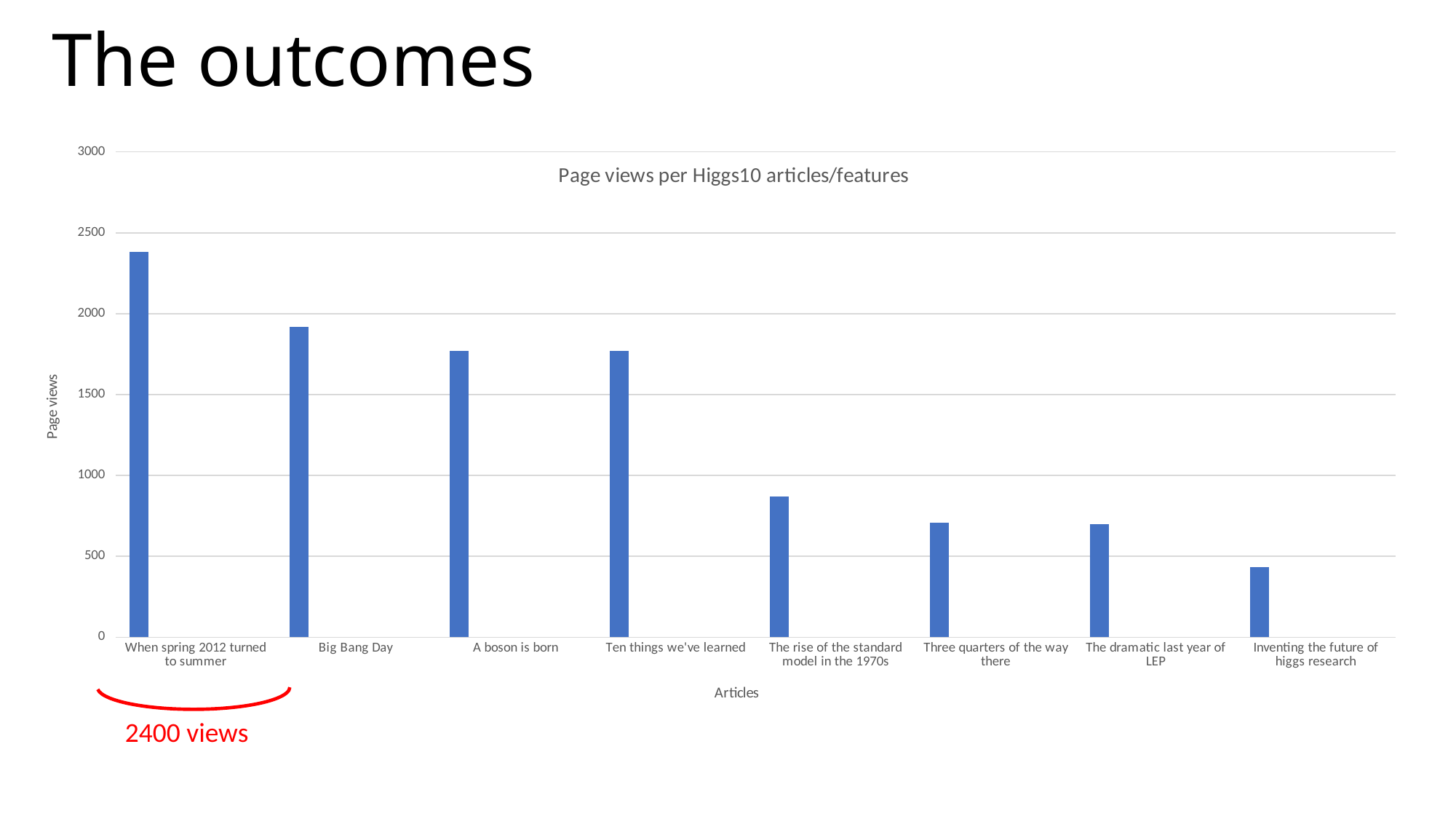
Is the value for Big Bang Day greater or less than 1500? greater How many articles are plotted in the chart? 8 Do the page views generally rise or fall moving from left to right across the articles? fall Is the value for Inventing the future of higgs research greater or less than 500? less Is the value for Three quarters of the way there greater or less than 500? greater Which has more page views, Big Bang Day or A boson is born? Big Bang Day Which article has the highest number of page views? When spring 2012 turned to summer Which article has the lowest number of page views? Inventing the future of higgs research What is the title of the chart? Page views per Higgs10 articles/features What is the label of the vertical axis? Page views What kind of chart is shown on the slide? bar chart